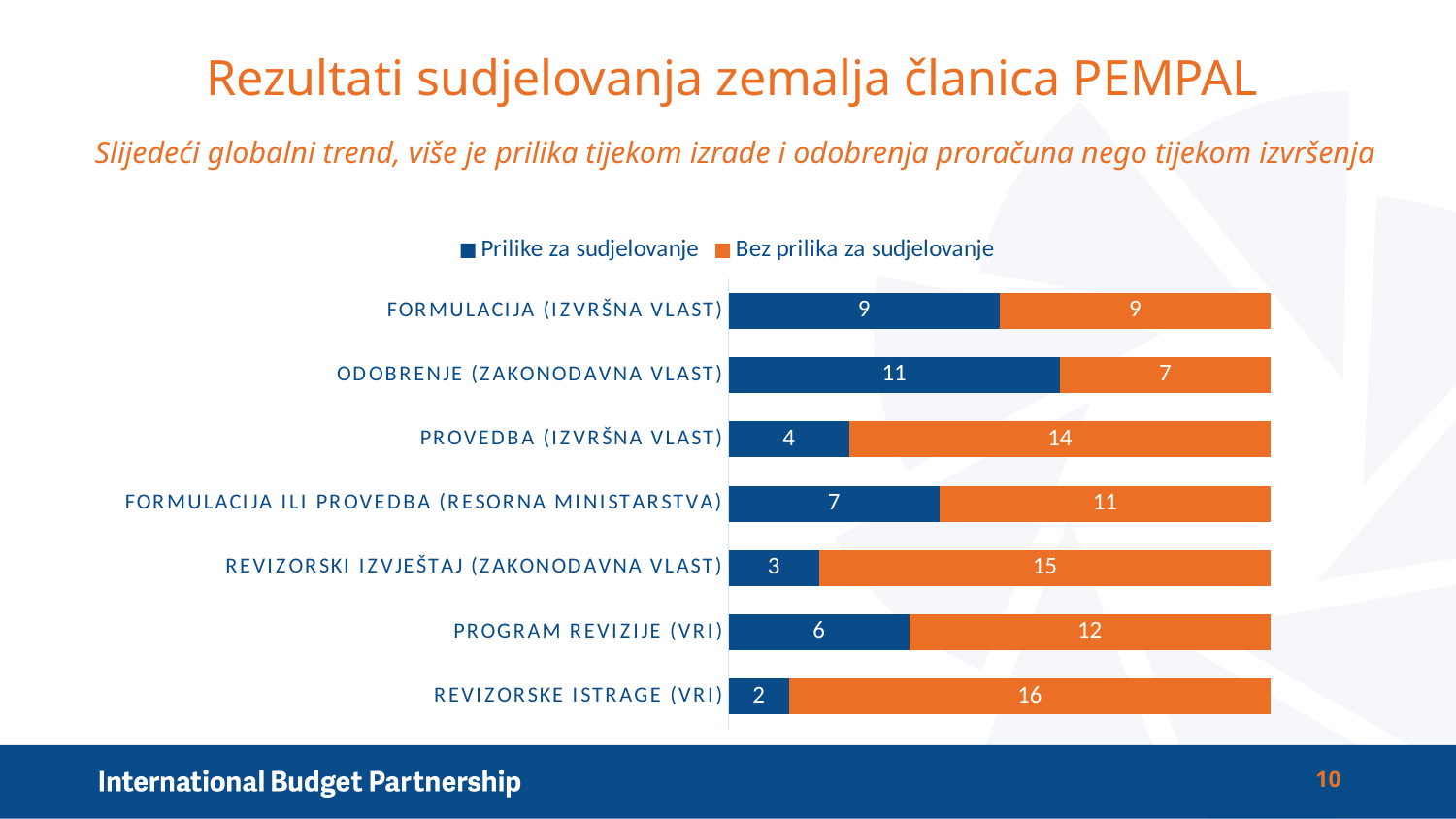
What is the value of "Bez prilika za sudjelovanje" for REVIZORSKE ISTRAGE (VRI)? 16 What kind of chart is shown on the slide? Stacked bar chart What is the difference between the "Bez prilika za sudjelovanje" and "Prilike za sudjelovanje" values for REVIZORSKI IZVJEŠTAJ (ZAKONODAVNA VLAST)? 12 What is the value of "Prilike za sudjelovanje" for ODOBRENJE (ZAKONODAVNA VLAST)? 11 Which colour represents "Bez prilika za sudjelovanje" in the chart? Orange Which category has the lowest value for "Prilike za sudjelovanje"? REVIZORSKE ISTRAGE (VRI) How many categories are shown in the chart? 7 Which is larger for FORMULACIJA ILI PROVEDBA (RESORNA MINISTARSTVA): "Prilike za sudjelovanje" or "Bez prilika za sudjelovanje"? Bez prilika za sudjelovanje What is the value of "Prilike za sudjelovanje" for PROVEDBA (IZVRŠNA VLAST)? 4 What is the total of the stacked bar for PROGRAM REVIZIJE (VRI)? 18 How many series does the legend list? 2 Which category has the highest value for "Prilike za sudjelovanje"? ODOBRENJE (ZAKONODAVNA VLAST)